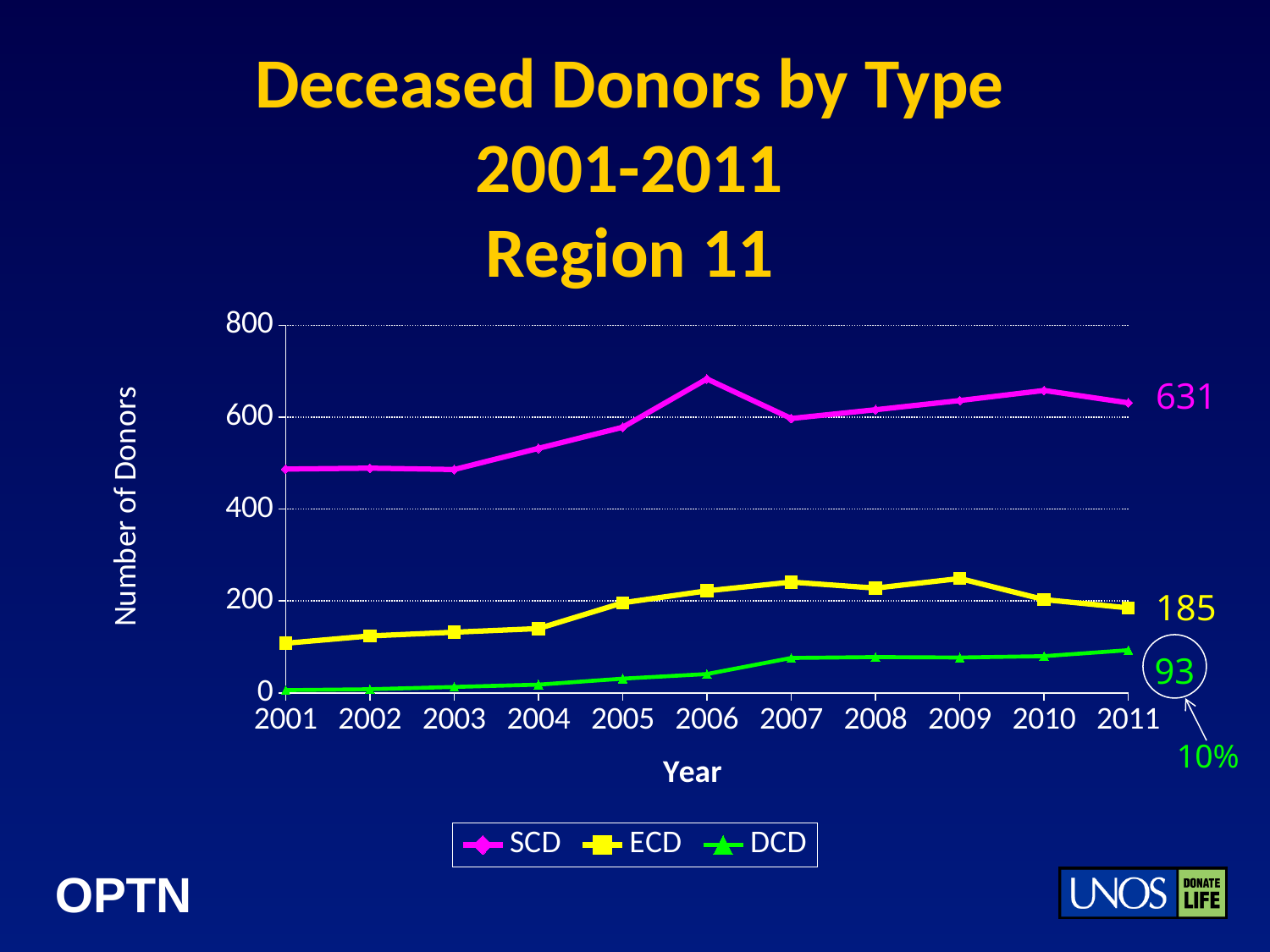
What is the difference between the SCD and ECD values in 2011? 446 Is the value for SCD in 2006 greater or less than 600? greater How many series does the legend list? 3 What kind of chart is shown on the slide? line chart Does the DCD series rise or fall from 2001 to 2011? rise In which year does the SCD series reach its highest value? 2006 Which series has the highest value in 2011? SCD What is the value for DCD in 2011? 93 How many years are shown on the x axis? 11 What is the value for ECD in 2011? 185 What is the value for SCD in 2011? 631 Is the value for ECD in 2001 greater or less than 200? less